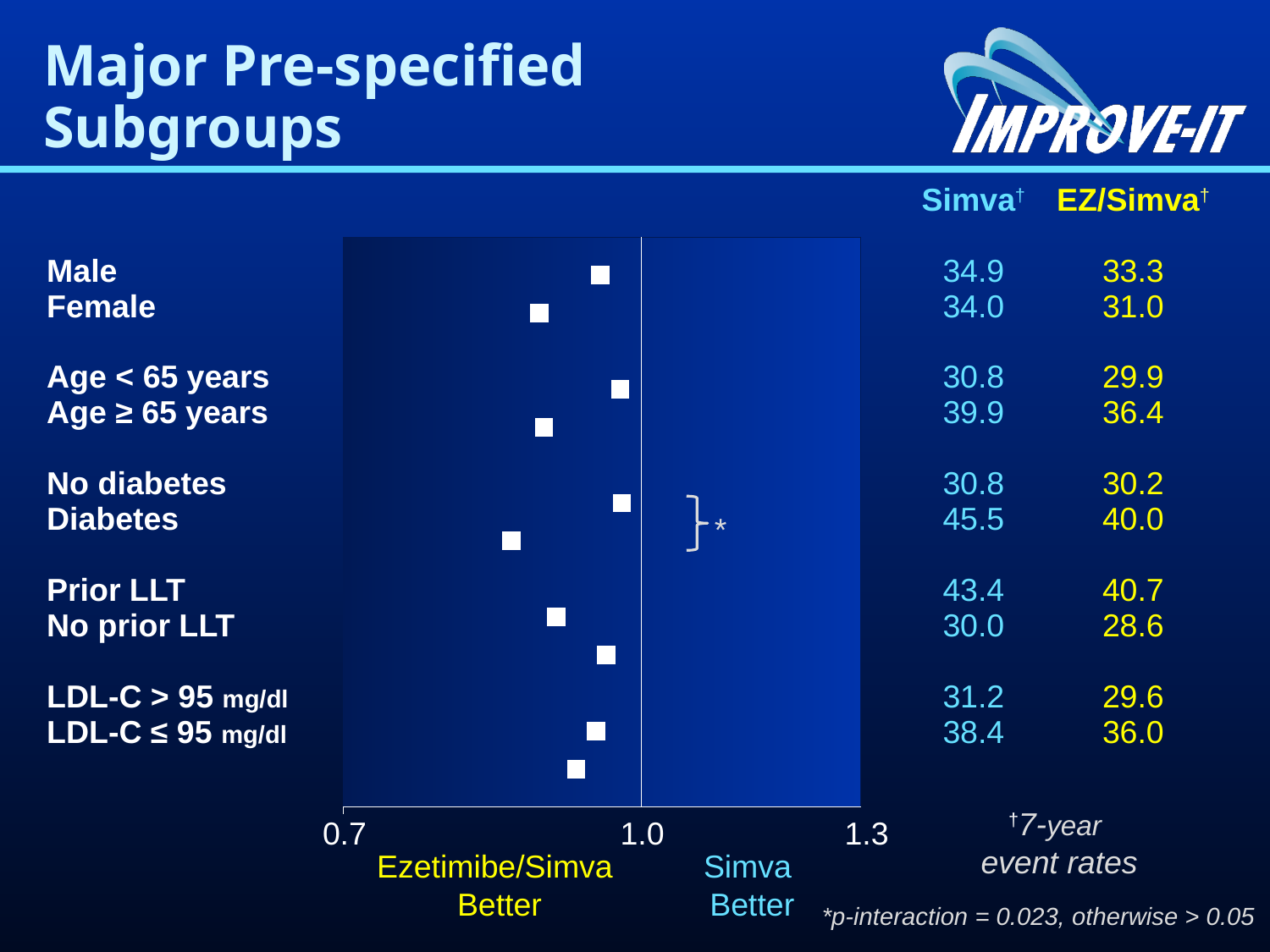
What is the difference between the Simva and EZ/Simva event rates in the Diabetes subgroup? 5.5 What is the 7-year event rate for EZ/Simva in the Diabetes subgroup? 40.0 What is the 7-year event rate for EZ/Simva in the No prior LLT subgroup? 28.6 What is the 7-year event rate for Simva in the Age ≥ 65 years subgroup? 39.9 Which subgroup has the lowest EZ/Simva 7-year event rate? No prior LLT Which is larger, the Simva event rate for Female or the Simva event rate for Male? Male How many subgroups are plotted in the chart? 10 What is the 7-year event rate for Simva in the Male subgroup? 34.9 Which subgroup comparison is marked with an asterisk for a significant p-interaction? No diabetes vs Diabetes Is the plotted hazard ratio for the Female subgroup greater or less than 1.0? less Which subgroup has the highest Simva 7-year event rate? Diabetes Is the plotted hazard ratio for the Diabetes subgroup greater or less than 1.0? less